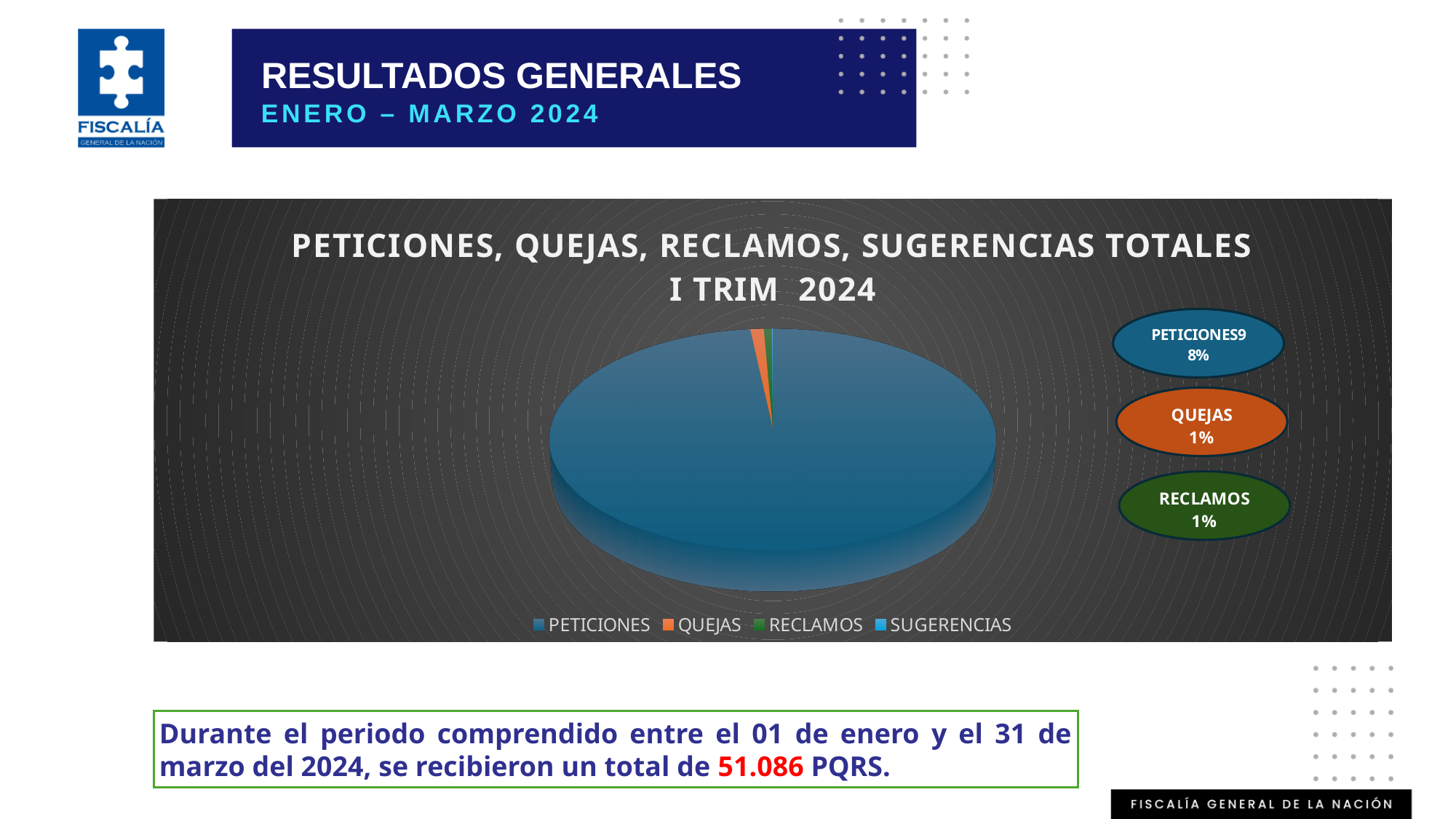
How many entries does the legend of the pie chart list? 4 What share of the pie does QUEJAS represent? 1% Which is larger, the slice for PETICIONES or the slice for QUEJAS? PETICIONES What share of the pie does PETICIONES represent? 98% What colour is the PETICIONES slice in the pie chart? blue Which two categories each have a share of 1%? QUEJAS and RECLAMOS What share of the pie does RECLAMOS represent? 1% What kind of chart is shown on the slide? pie chart What is the title of the pie chart? PETICIONES, QUEJAS, RECLAMOS, SUGERENCIAS TOTALES I TRIM 2024 Which is larger, the slice for PETICIONES or the slice for RECLAMOS? PETICIONES Which category has the largest slice of the pie? PETICIONES